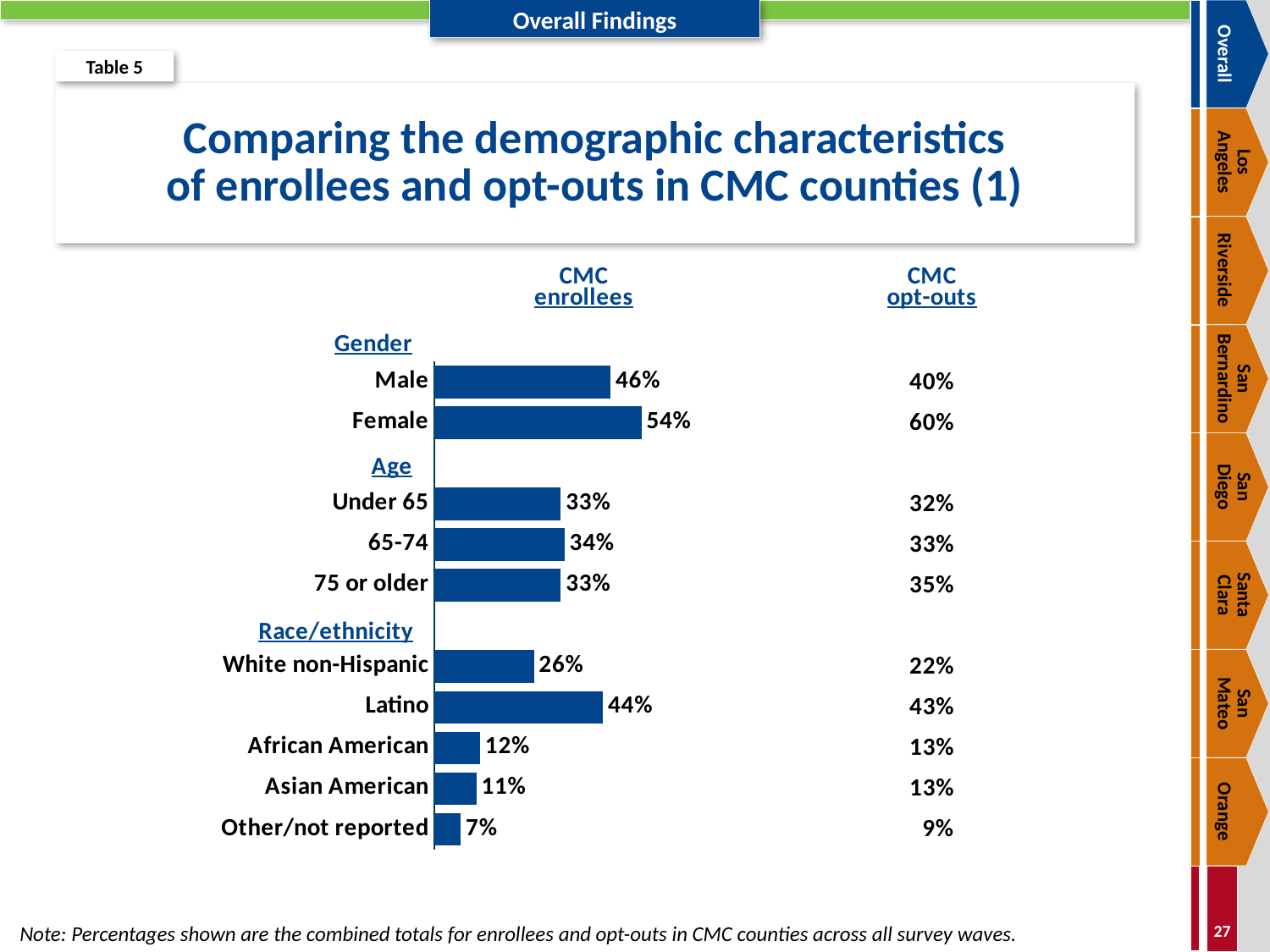
What type of chart is used to show the CMC enrollees percentages? Bar chart How many categories have bars in the CMC enrollees chart? 10 Which is larger for CMC enrollees: the Latino percentage or the White non-Hispanic percentage? Latino What percentage of CMC enrollees are Latino? 44% What percentage of CMC opt-outs are Female? 60% What percentage of CMC enrollees are Asian American? 11% What is the difference between the CMC enrollees and CMC opt-outs percentages for White non-Hispanic? 4% Which category has the shortest bar for CMC enrollees? Other/not reported Which category has the longest bar for CMC enrollees? Female What percentage of CMC enrollees are Male? 46% What is the difference between the Female and Male percentages for CMC enrollees? 8% What is the title of the slide's chart? Comparing the demographic characteristics of enrollees and opt-outs in CMC counties (1)